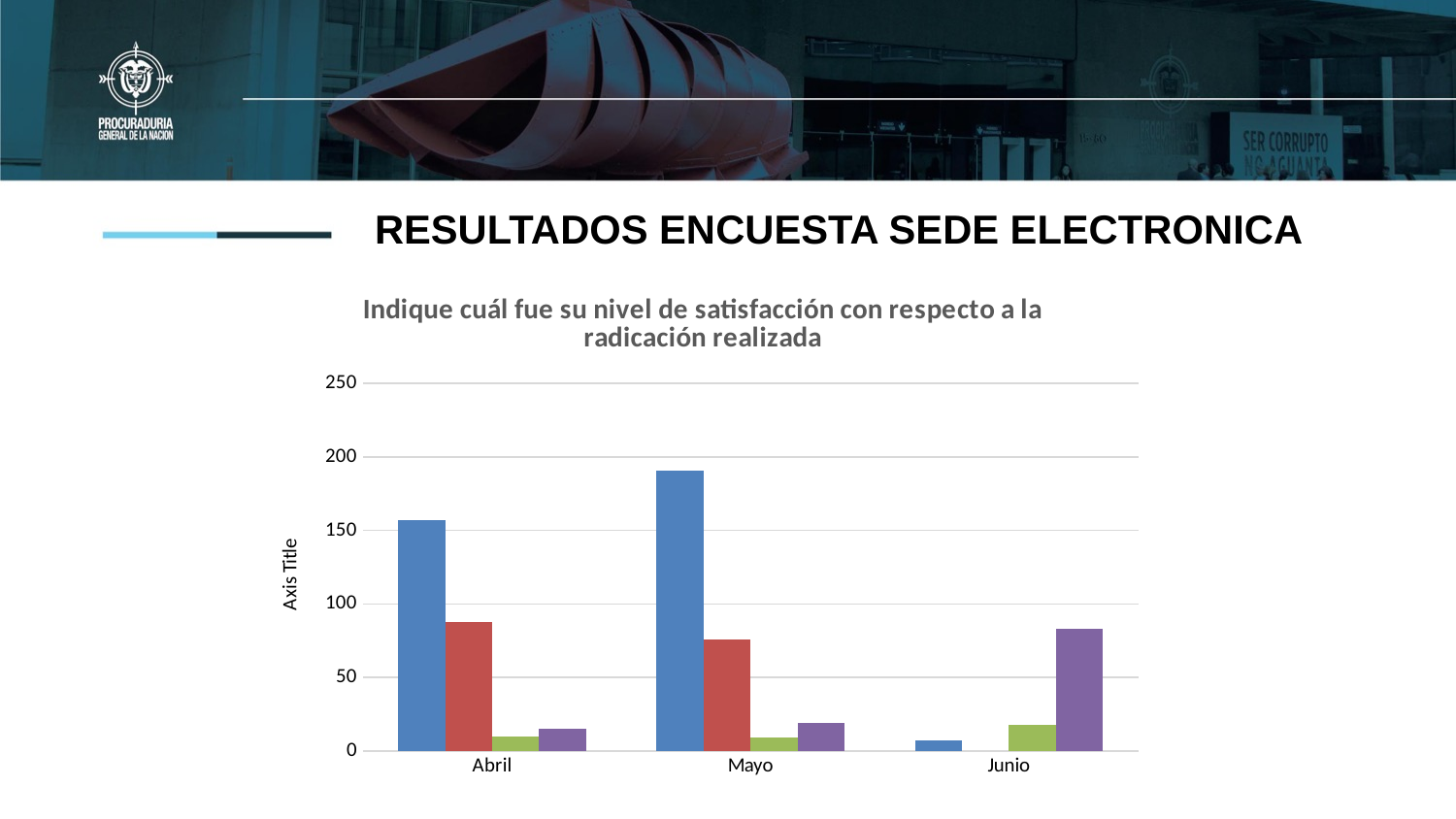
How many months are shown on the x axis of the chart? 3 What is the title of the chart? Indique cuál fue su nivel de satisfacción con respecto a la radicación realizada Is the value of the red bar for Abril greater or less than 100? less Which month has the tallest blue bar? Mayo Is the value of the purple bar for Junio greater or less than 50? greater Which is larger, the red bar for Abril or the red bar for Mayo? Abril What is the label on the vertical axis of the chart? Axis Title Is the value of the blue bar for Mayo greater or less than 150? greater What kind of chart is shown on the slide? bar chart Which month has the shortest blue bar? Junio Which is larger for Junio, the purple bar or the green bar? purple